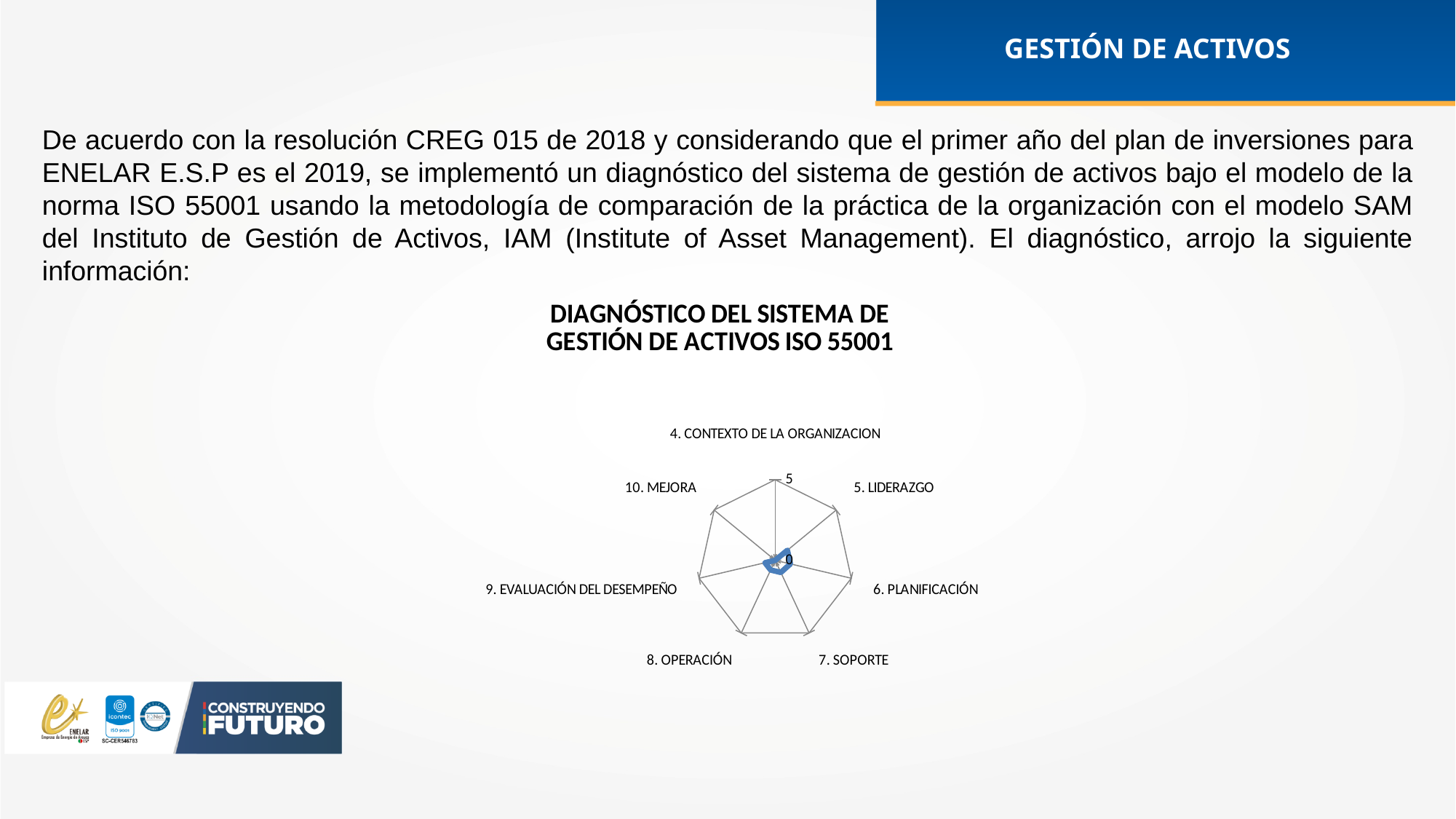
Which category label appears at the top of the radar chart? 4. CONTEXTO DE LA ORGANIZACION Is the value for 5. LIDERAZGO greater or less than 5? less How many categories (axes) does the radar chart have? 7 Is the value for 4. CONTEXTO DE LA ORGANIZACION greater or less than 5? less What is the title of the chart? DIAGNÓSTICO DEL SISTEMA DE GESTIÓN DE ACTIVOS ISO 55001 What is the maximum value shown on the chart's axis scale? 5 What kind of chart is shown on the slide? Radar chart Is the value for 9. EVALUACIÓN DEL DESEMPEÑO greater or less than 5? less